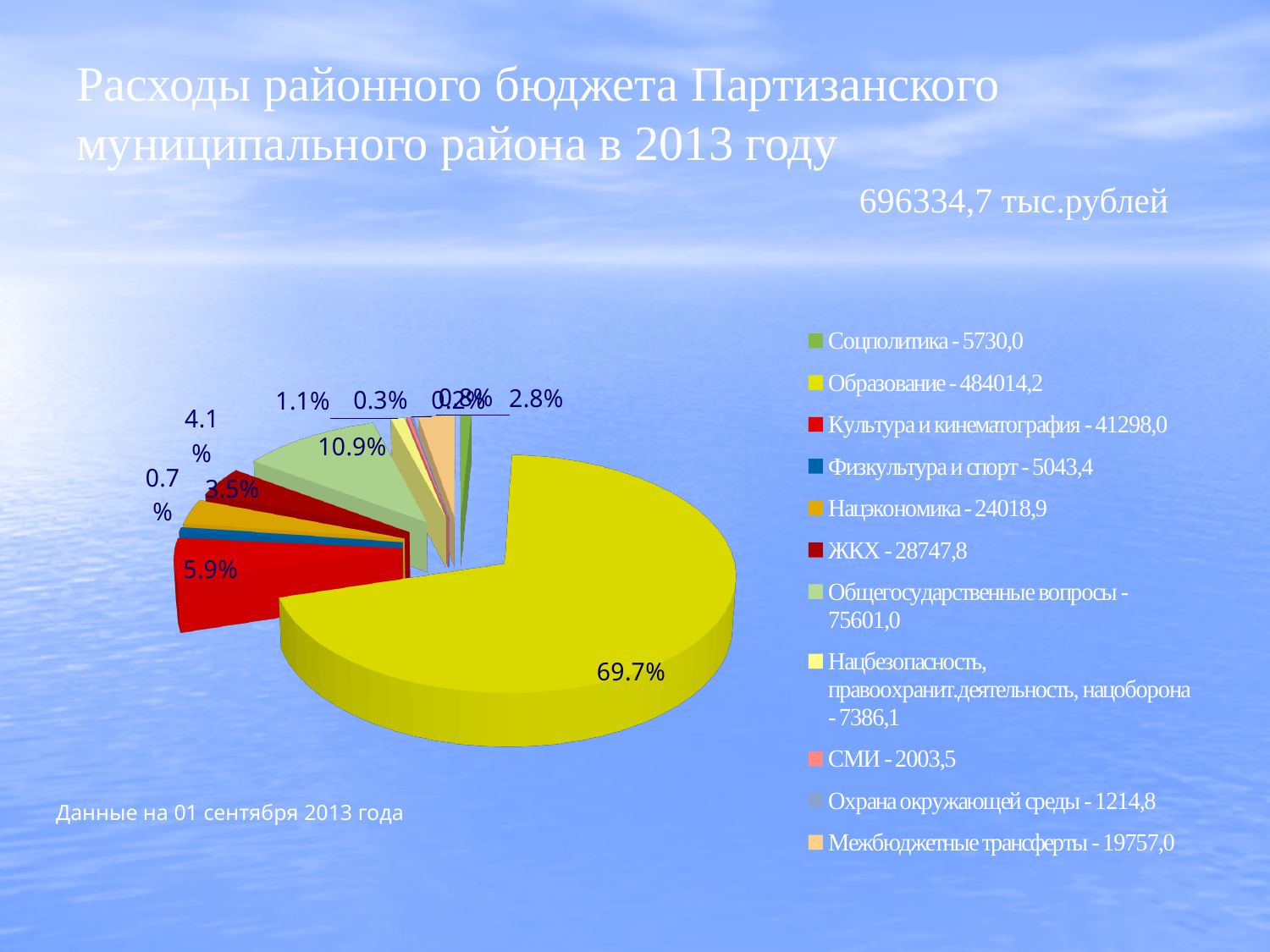
What kind of chart is shown on the slide? pie chart What value is given for Образование in the legend? 484014,2 What share of the pie does Общегосударственные вопросы take? 10.9% Which category has the largest share of the pie? Образование What total amount in thousand rubles is stated on the slide for the budget expenditures? 696334,7 тыс.рублей What value is given for Межбюджетные трансферты in the legend? 19757,0 Which category has the smallest value in the legend? Охрана окружающей среды What is the difference between the values for ЖКХ and Нацэкономика? 4728,9 What value is given for ЖКХ in the legend? 28747,8 What share of the pie does Образование take? 69.7% Which is larger, Нацэкономика or ЖКХ? ЖКХ How many categories does the legend of the pie chart list? 11